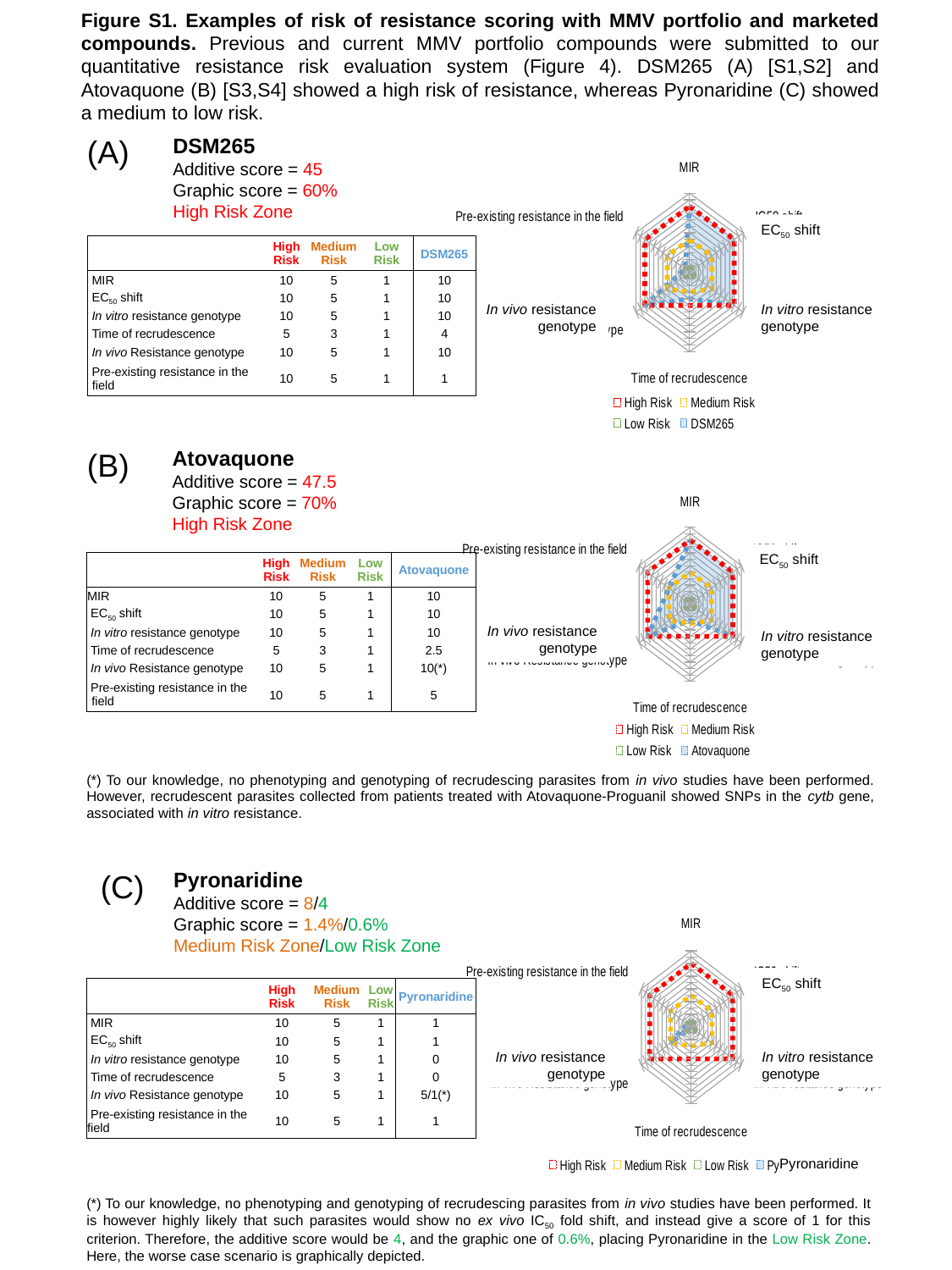
In the DSM265 chart in panel (A), how many axes (criteria) are plotted around the radar? 6 In the Atovaquone chart in panel (B), how many series does the legend list? 4 In the DSM265 chart in panel (A), is the DSM265 value larger for MIR or for Pre-existing resistance in the field? MIR In the Pyronaridine chart in panel (C), how many series does the legend list? 4 In the DSM265 chart in panel (A), how many series does the legend list? 4 In the Pyronaridine chart in panel (C), which colour is used for the High Risk series? Red In the Pyronaridine chart in panel (C), how many criteria are plotted around the radar? 6 What kind of chart is shown for DSM265 in panel (A)? Radar chart In the DSM265 chart in panel (A), which criterion has the lowest DSM265 value? Pre-existing resistance in the field What kind of chart is shown for Pyronaridine in panel (C)? Radar chart In the Atovaquone chart in panel (B), what are the four legend entries? High Risk, Medium Risk, Low Risk, Atovaquone